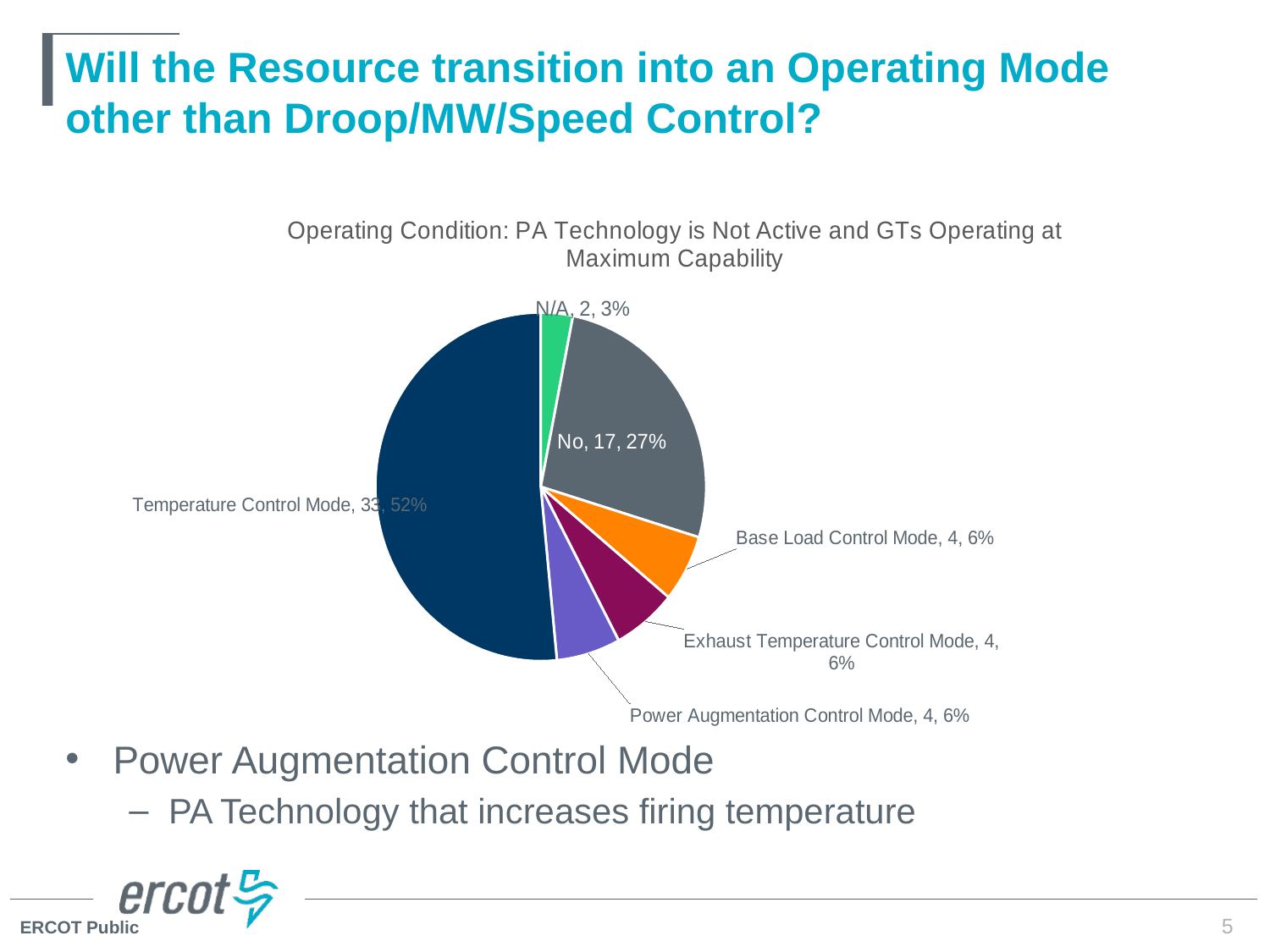
What is the count for N/A? 2 Which category has the largest slice? Temperature Control Mode What type of chart is shown on the slide? pie chart Which is larger, the count for No or the count for Base Load Control Mode? No Which category has the smallest slice? N/A What is the count for Exhaust Temperature Control Mode? 4 What percentage share does the No slice represent? 27% How many slices does the pie chart have? 6 What is the title of the pie chart? Operating Condition: PA Technology is Not Active and GTs Operating at Maximum Capability What is the count for Temperature Control Mode? 33 What percentage share does Power Augmentation Control Mode represent? 6% What is the difference between the counts for Temperature Control Mode and No? 16